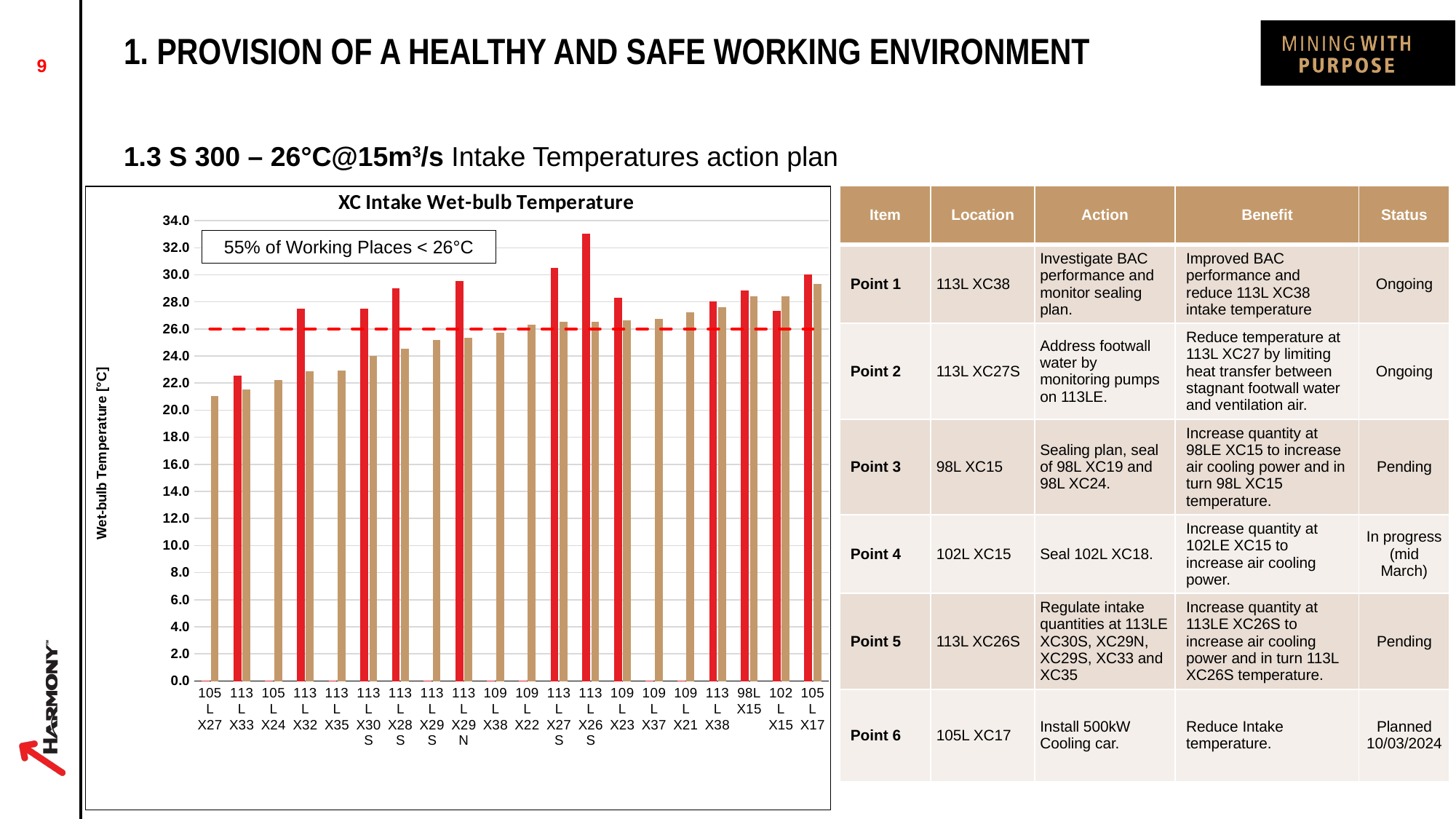
Is the bar for 113L X35 greater or less than 24.0? less How many locations (categories) are plotted along the x axis of the chart? 20 Do the bar heights generally rise or fall from left to right along the x axis? rise Is the red bar for 113L X26S greater or less than 32.0? greater Which has the taller red bar, 113L X26S or 113L X27S? 113L X26S Which location has the highest bar in the chart? 113L X26S Is the red bar for 113L X27S greater or less than 30.0? greater What is the title of the chart? XC Intake Wet-bulb Temperature What type of chart is shown on the slide? Bar chart What is the label on the vertical axis of the chart? Wet-bulb Temperature [°C]